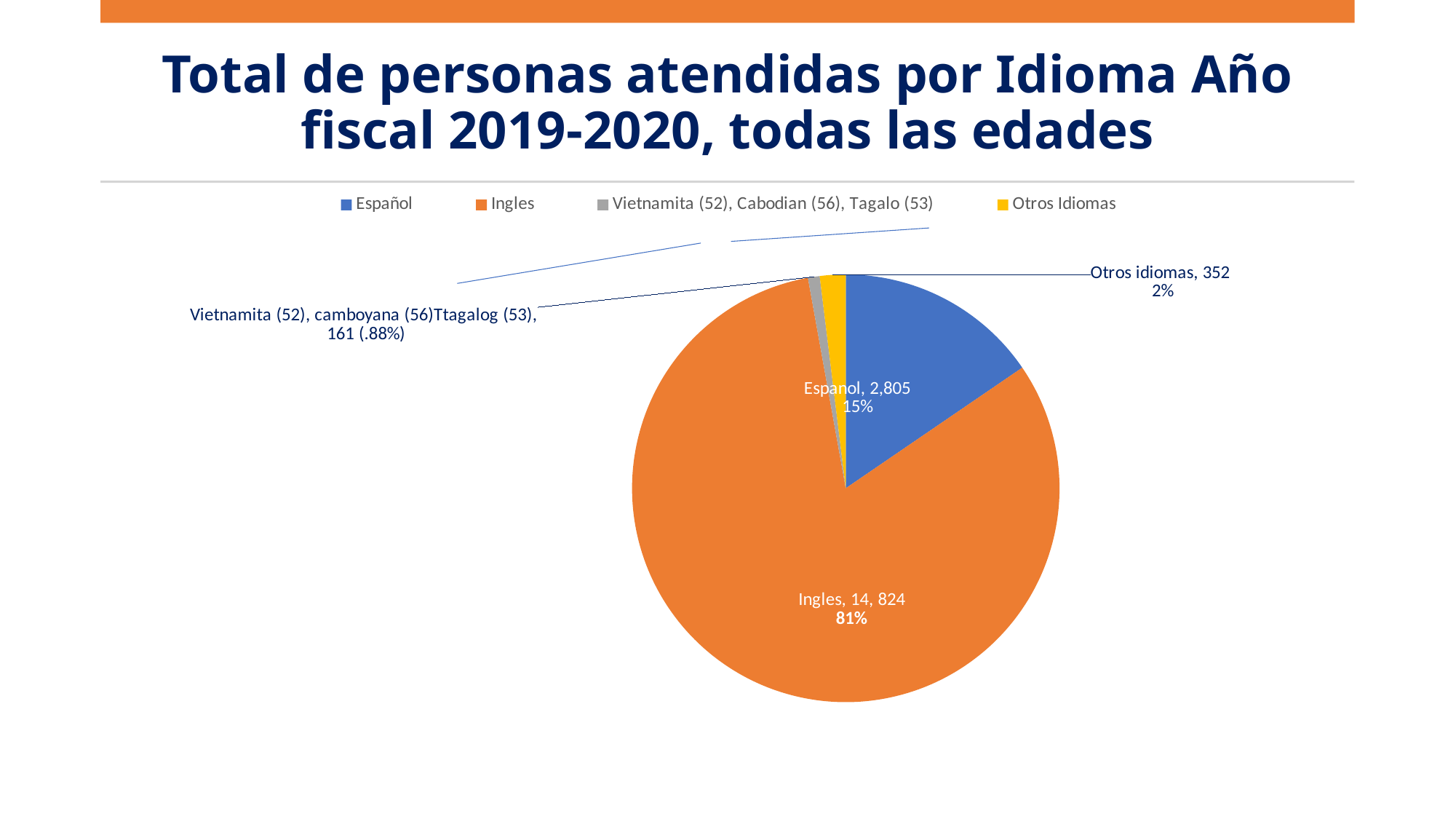
What is the difference between the values for Espanol and Otros idiomas? 2,453 Which language has the largest slice of the pie? Ingles What kind of chart is shown on the slide? pie chart What is the value shown for Otros idiomas? 352 What share of the pie does Espanol represent? 15% How many entries does the legend list? 4 What is the value shown for Ingles? 14, 824 How many slices does the pie chart have? 4 What share of the pie does Ingles represent? 81% What is the value shown for the Vietnamita, camboyana, Tagalog slice? 161 Which slice of the pie is the smallest? Vietnamita (52), camboyana (56), Tagalog (53) What is the value shown for Espanol? 2,805